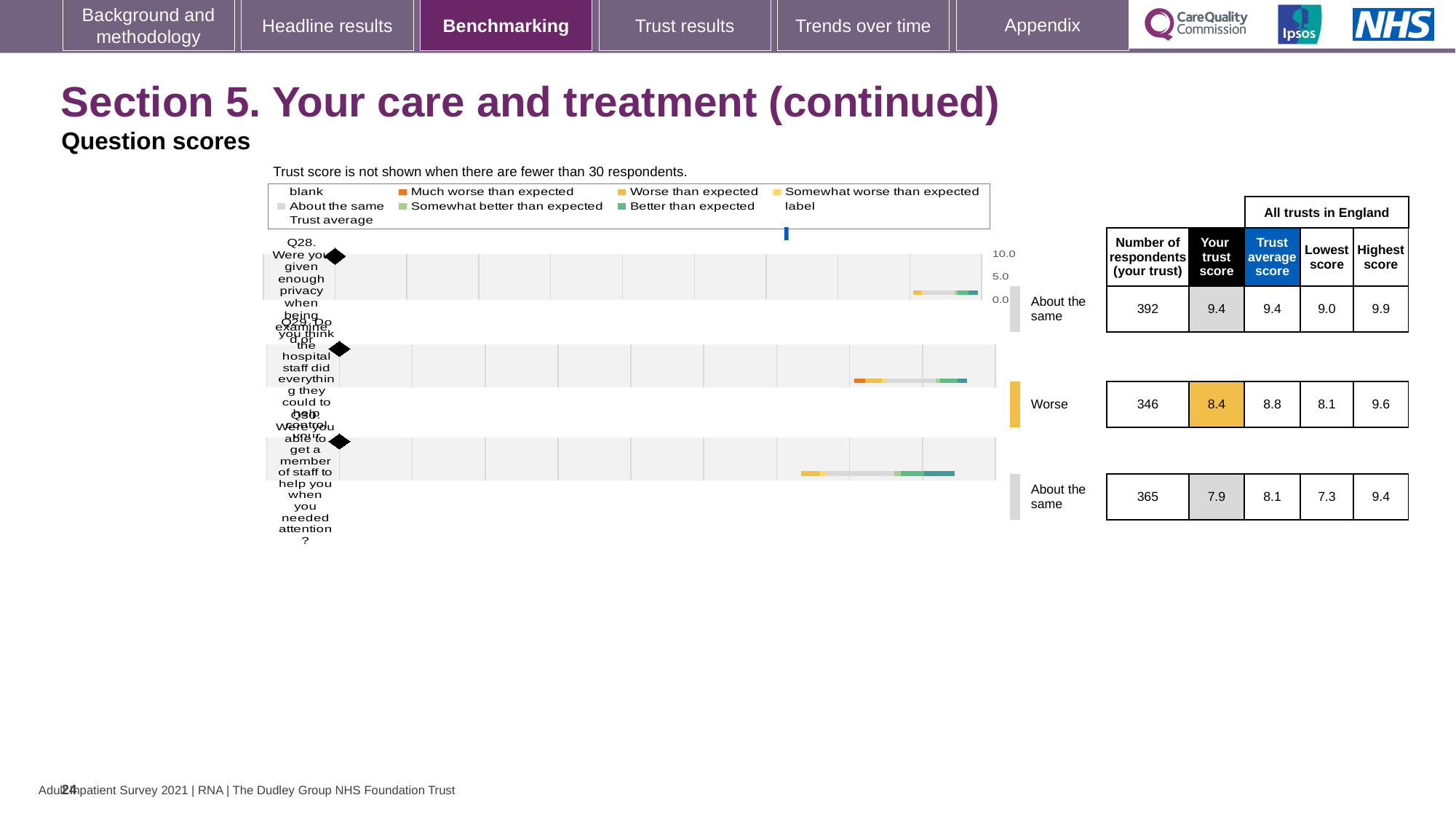
How many respondents answered Q28 at this trust? 392 What is the trust score shown for Q30 (Were you able to get a member of staff to help you when you needed attention?)? 7.9 What is the trust score shown for Q28 (Were you given enough privacy when being examined or treated?)? 9.4 What is the trust score shown for Q29 (Do you think the hospital staff did everything they could to help control your pain?)? 8.4 Which benchmark category is Q29 rated as? Worse Which of the three questions (Q28, Q29, Q30) has the highest trust score? Q28 How many question charts are shown on the slide? 3 What is the difference between the trust average score and this trust's score for Q29? 0.4 Which of the three questions (Q28, Q29, Q30) has the lowest trust score? Q30 What is the highest score across all trusts in England for Q30? 9.4 Is the trust score for Q30 greater or less than the trust average score for Q30? less What is the trust average score for Q29? 8.8